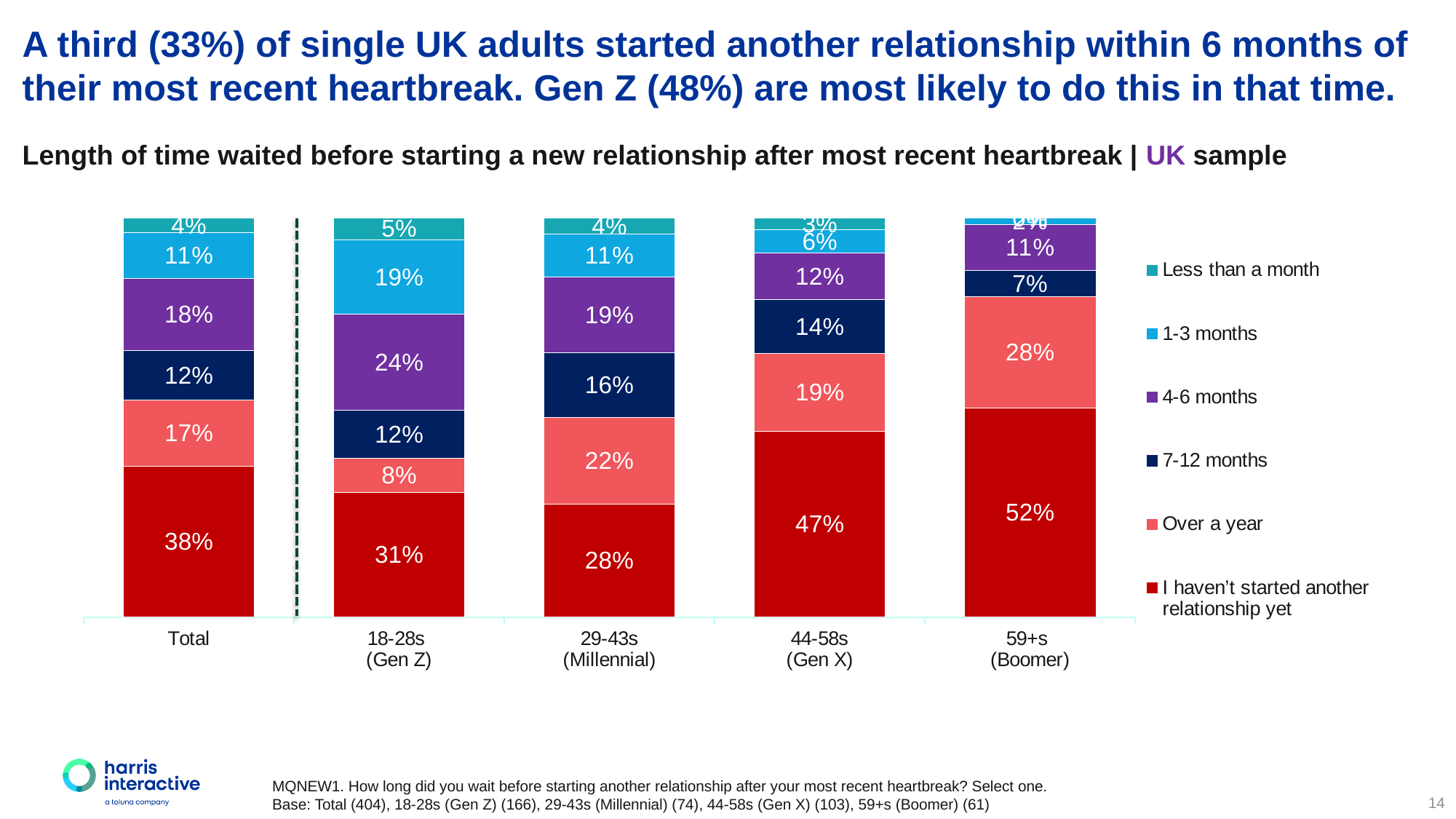
What type of chart is shown on the slide? Stacked bar chart What percentage of 29-43s (Millennial) waited over a year? 22% What percentage of 59+s (Boomer) waited over a year? 28% How many groups (bars) are shown on the x axis of the chart? 5 How many percentage points higher is the 1-3 months share for 18-28s (Gen Z) than for the Total sample? 8 percentage points Which group has a larger share waiting over a year: 18-28s (Gen Z) or 44-58s (Gen X)? 44-58s (Gen X) Which age group has the lowest share saying "I haven't started another relationship yet"? 29-43s (Millennial) What percentage of the Total sample said "I haven't started another relationship yet"? 38% Which age group has the highest share saying "I haven't started another relationship yet"? 59+s (Boomer) What percentage of 44-58s (Gen X) waited 7-12 months? 14% What percentage of 18-28s (Gen Z) waited 4-6 months before starting a new relationship? 24% How many series does the legend list? 6